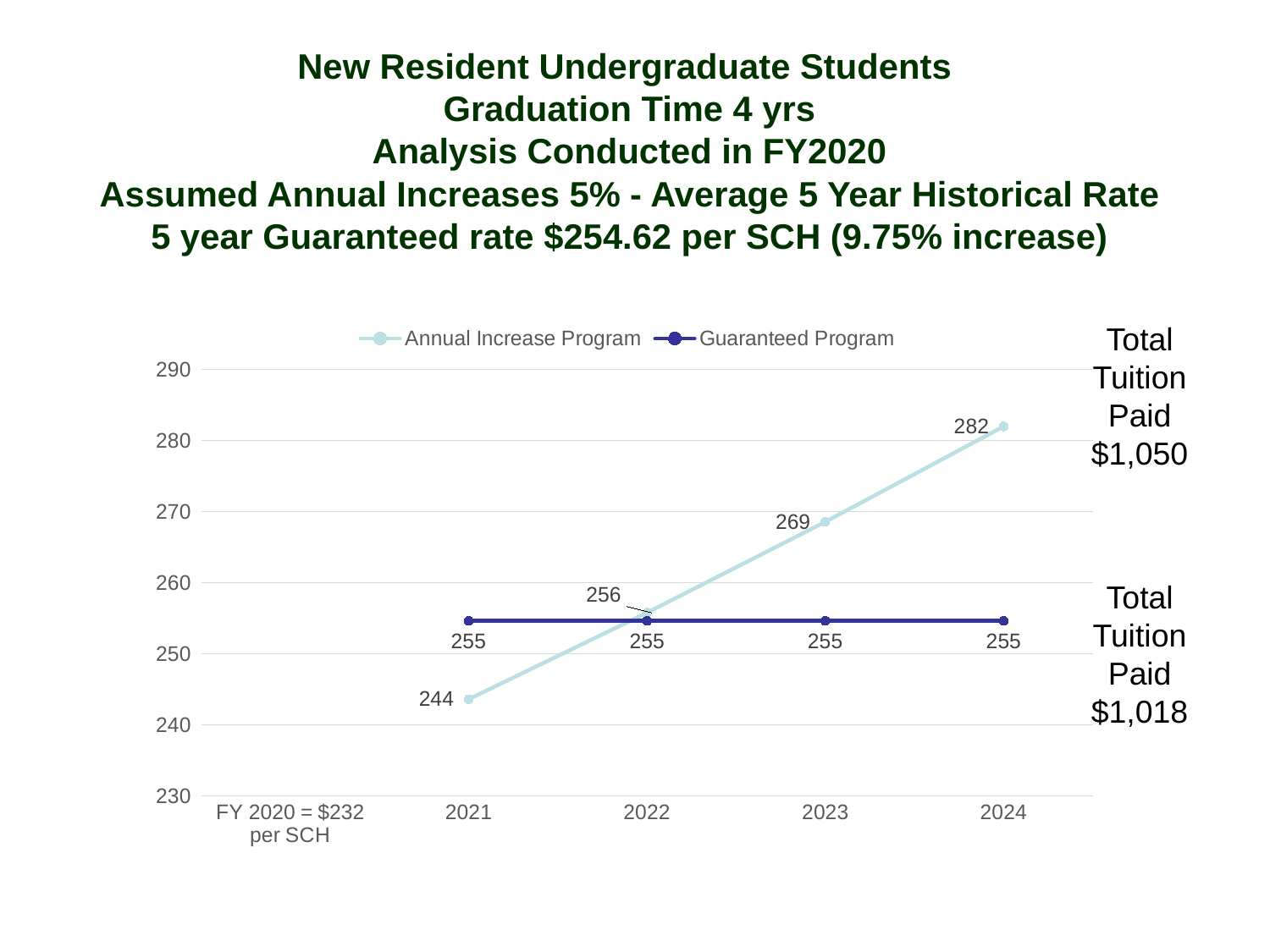
In 2021, which series has the larger value, Annual Increase Program or Guaranteed Program? Guaranteed Program What is the value of the Annual Increase Program in 2024? 282 How many data points are plotted for the Guaranteed Program series? 4 What is the value of the Guaranteed Program in 2023? 255 What total tuition paid is shown next to the Guaranteed Program line? $1,018 Does the Annual Increase Program rise or fall from 2021 to 2024? rise What type of chart is shown on the slide? line chart In which year is the Annual Increase Program value highest? 2024 How many series does the legend list? 2 What is the difference between the Annual Increase Program and the Guaranteed Program values in 2024? 27 What is the value of the Annual Increase Program in 2021? 244 In which year is the Annual Increase Program value lowest? 2021